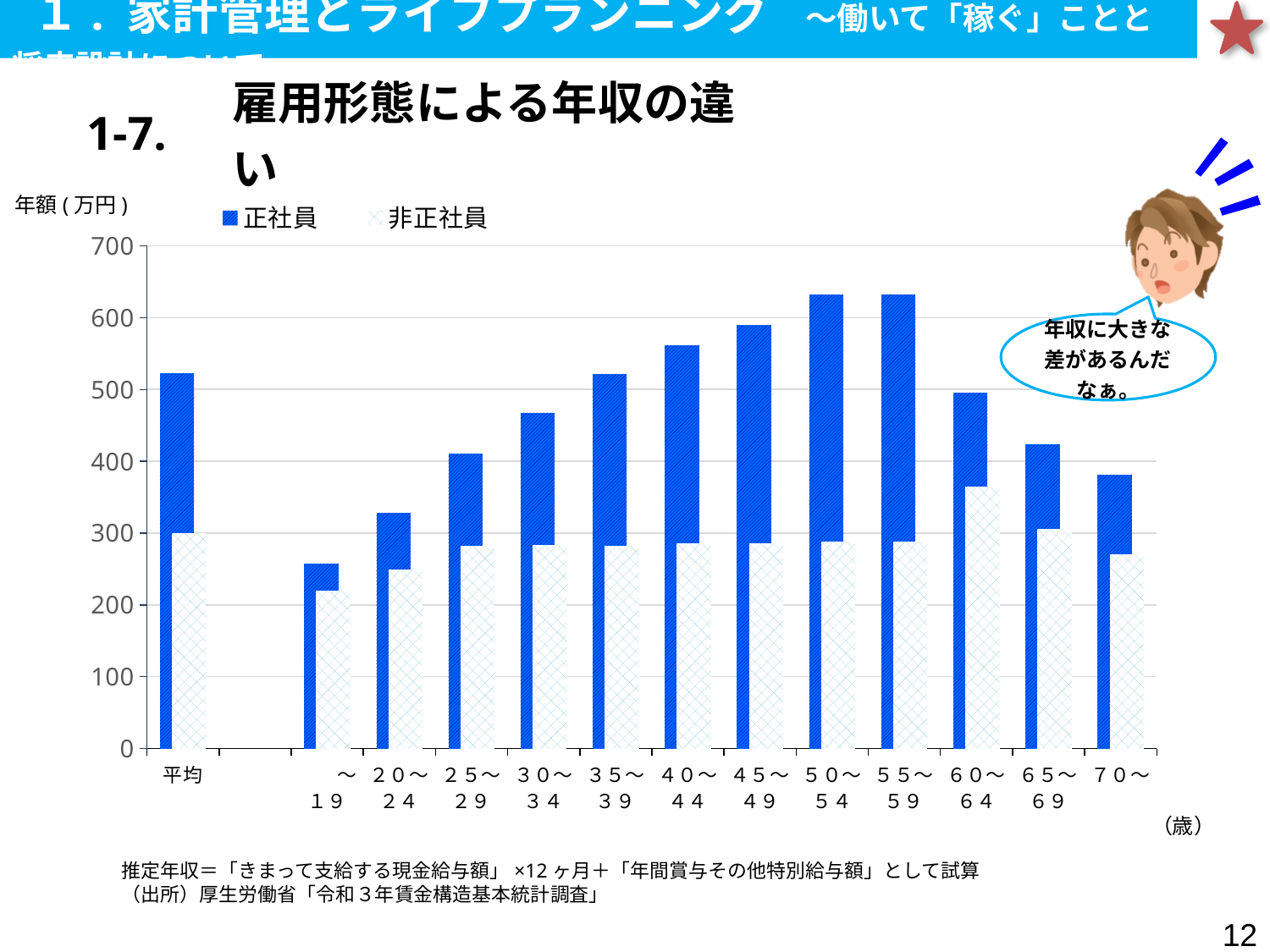
Is the value for 正社員 in the 平均 category greater or less than 500? greater How many categories are shown on the x axis? 13 Which age group has the lowest value for 非正社員? ～19 Is the value for 正社員 in the 70～ age group greater or less than 400? less Do the 正社員 values rise or fall from the ～19 age group to the 50～54 age group? rise What kind of chart is shown on the slide? bar chart Which age group has the lowest value for 正社員? ～19 Which age group has the highest value for 非正社員? 60～64 Is the value for 正社員 in the 50～54 age group greater or less than 600? greater In the 40～44 age group, which is larger, 正社員 or 非正社員? 正社員 How many series does the legend list? 2